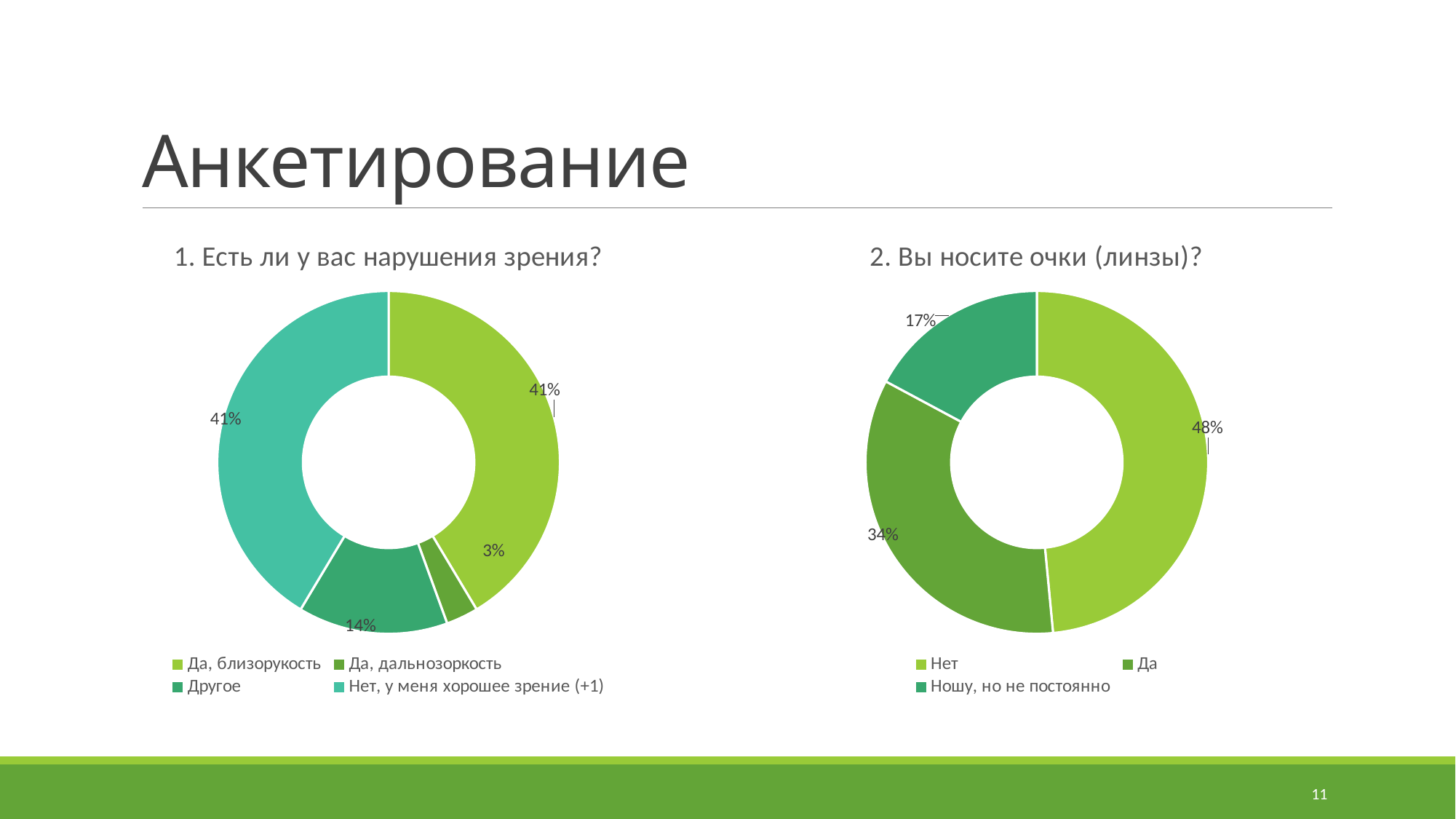
In the chart "1. Есть ли у вас нарушения зрения?", what percentage is shown for "Другое"? 14% In the chart "1. Есть ли у вас нарушения зрения?", what percentage is shown for "Да, дальнозоркость"? 3% In the chart "1. Есть ли у вас нарушения зрения?", which category has the smallest share? Да, дальнозоркость In the chart "2. Вы носите очки (линзы)?", which category has the largest share? Нет In the chart "2. Вы носите очки (линзы)?", which is larger: "Да" or "Ношу, но не постоянно"? Да In the chart "2. Вы носите очки (линзы)?", what percentage is shown for "Нет"? 48% What type of chart is used for "2. Вы носите очки (линзы)?"? Doughnut (pie) chart In the chart "2. Вы носите очки (линзы)?", what percentage is shown for "Ношу, но не постоянно"? 17% In the chart "1. Есть ли у вас нарушения зрения?", what percentage is shown for "Да, близорукость"? 41% In the chart "2. Вы носите очки (линзы)?", what is the difference between the shares of "Нет" and "Да"? 14% In the chart "1. Есть ли у вас нарушения зрения?", how many categories does the legend list? 4 In the chart "1. Есть ли у вас нарушения зрения?", what is the difference between the shares of "Другое" and "Да, дальнозоркость"? 11%